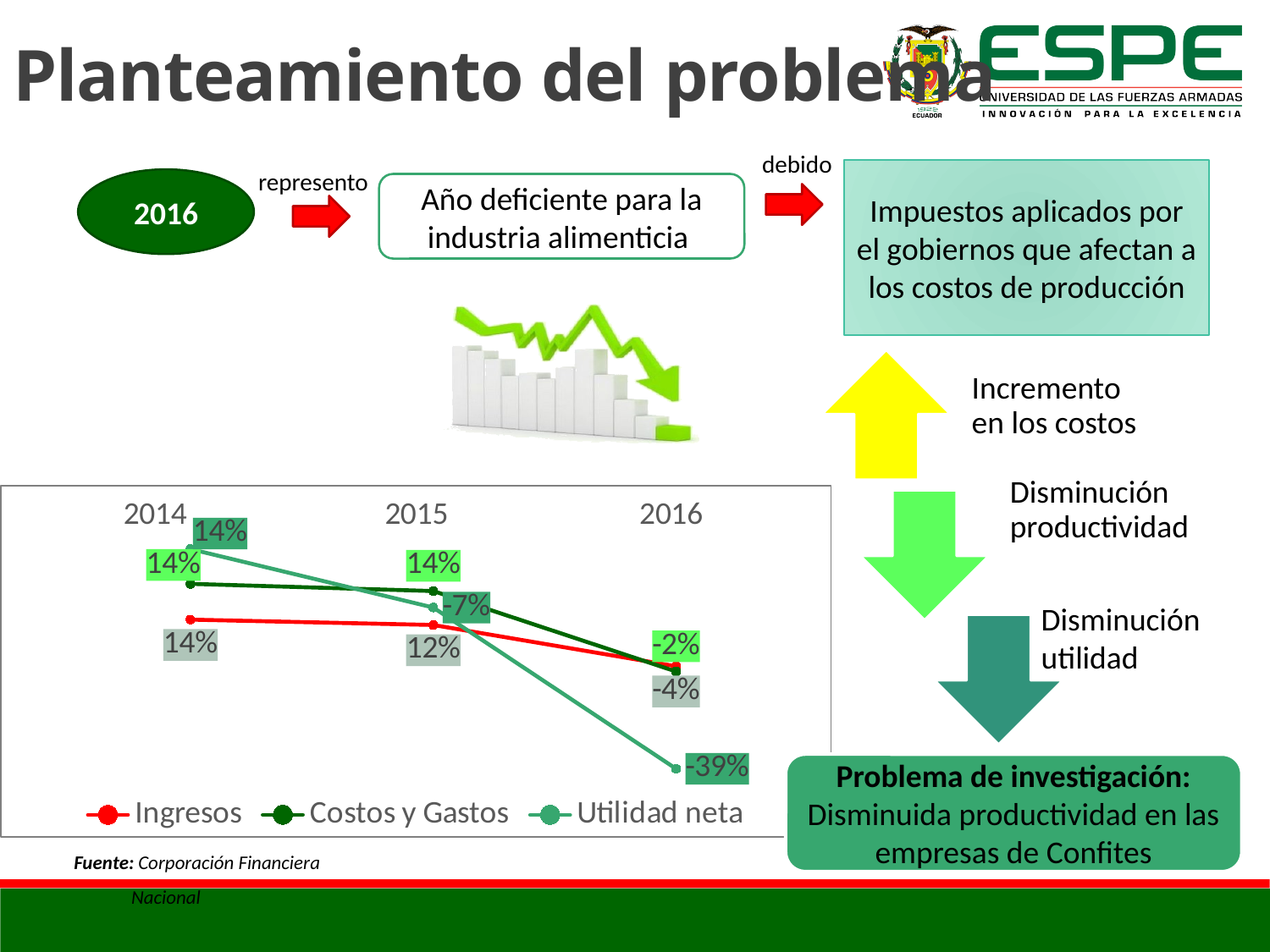
How many years are shown on the x axis of the chart? 3 What is the value for Utilidad neta in 2015? -7% Which is larger in 2016, Costos y Gastos or Ingresos? Costos y Gastos What is the value for Utilidad neta in 2016? -39% What kind of chart is shown on the slide? Line chart What is the value for Costos y Gastos in 2016? -2% Does Utilidad neta rise or fall from 2014 to 2016? Fall How many series does the chart legend list? 3 What is the difference between the Ingresos values for 2014 and 2015? 2% What is the value for Ingresos in 2015? 12% What is the value for Ingresos in 2016? -4% In which year is Utilidad neta lowest? 2016